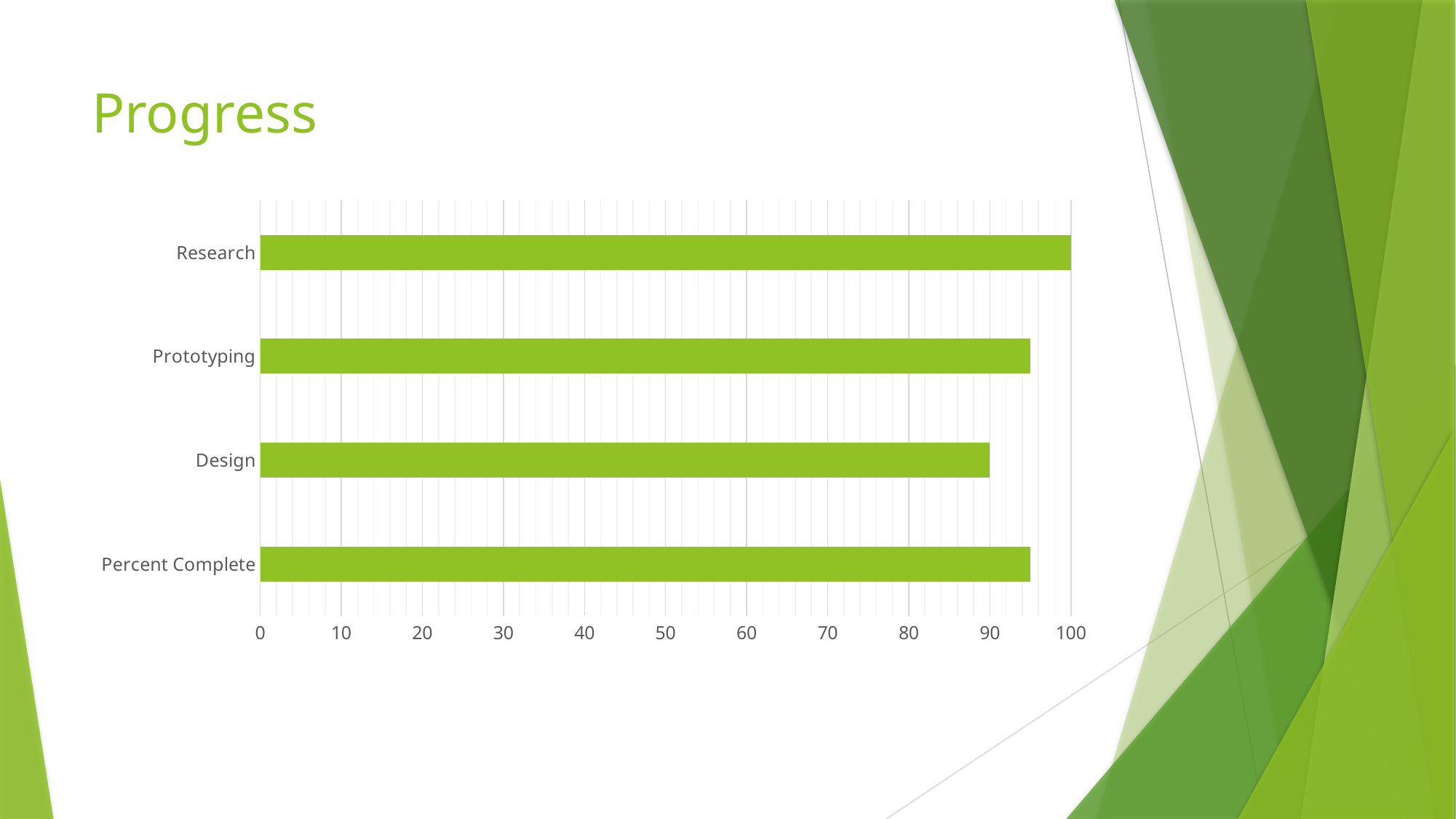
What is the value for Research? 100 What is the difference between the values for Research and Design? 10 What is the title of the slide? Progress Which is larger, the value for Research or the value for Design? Research What is the value for Design? 90 How many categories are shown in the chart? 4 Which category has the lowest value? Design Is the value for Percent Complete greater or less than 100? less Which category has the highest value? Research Is the value for Design greater or less than 80? greater Is the value for Prototyping greater or less than 90? greater What kind of chart is shown on the slide? bar chart